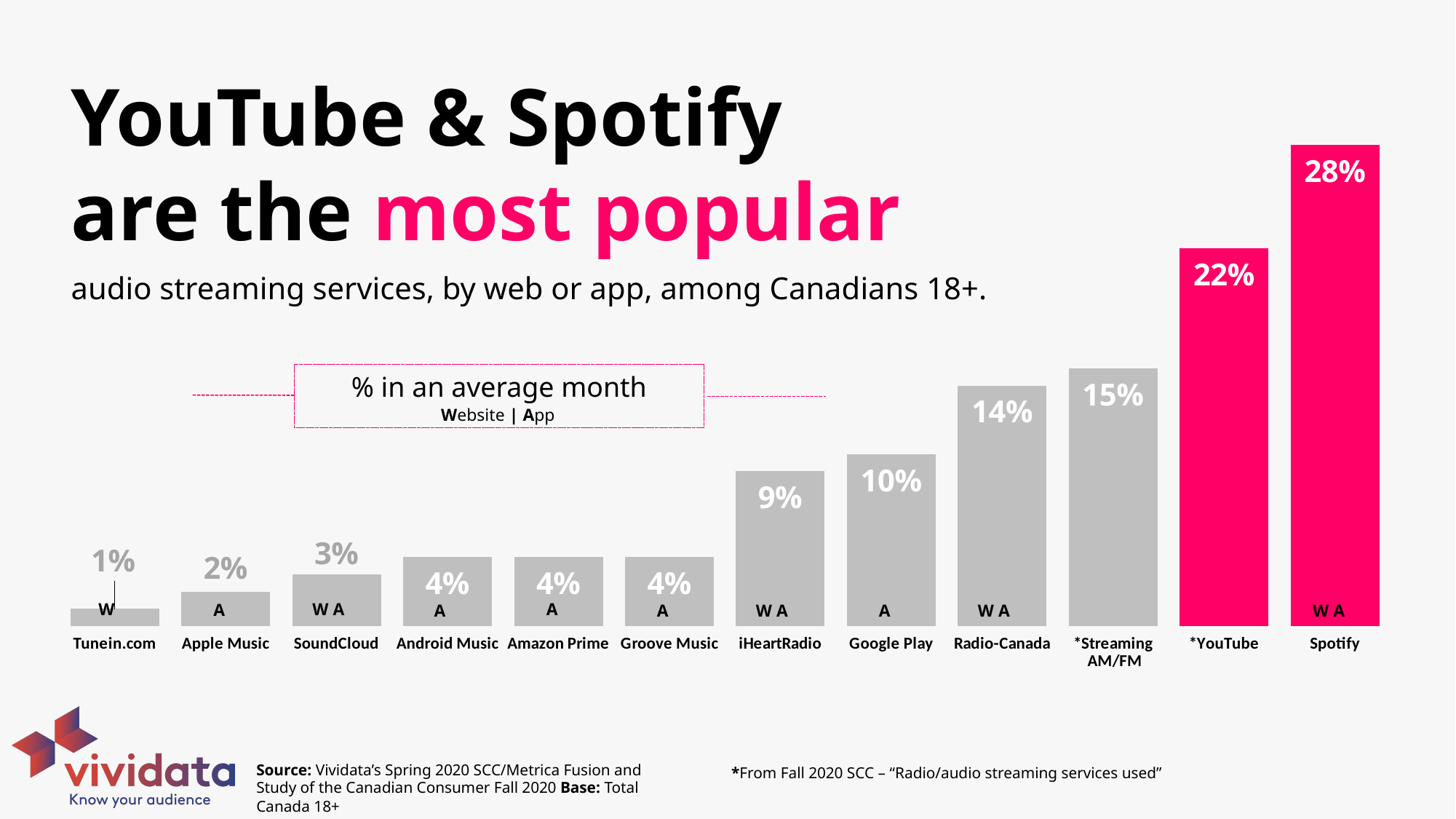
What is the difference between the values for Streaming AM/FM and Google Play? 5% Which audio streaming service has the lowest value on the chart? Tunein.com What kind of chart is shown on the slide? Bar chart Which two bars are highlighted in pink on the chart? YouTube and Spotify What is the difference between the values for Spotify and YouTube? 6% What is the value shown for Radio-Canada? 14% Which audio streaming service has the highest value on the chart? Spotify What percentage of Canadians 18+ use Spotify in an average month? 28% How many audio streaming services are shown on the chart? 12 Do the values rise or fall moving from left to right across the chart? Rise What is the value shown for iHeartRadio? 9% Which has a higher value, Radio-Canada or Google Play? Radio-Canada